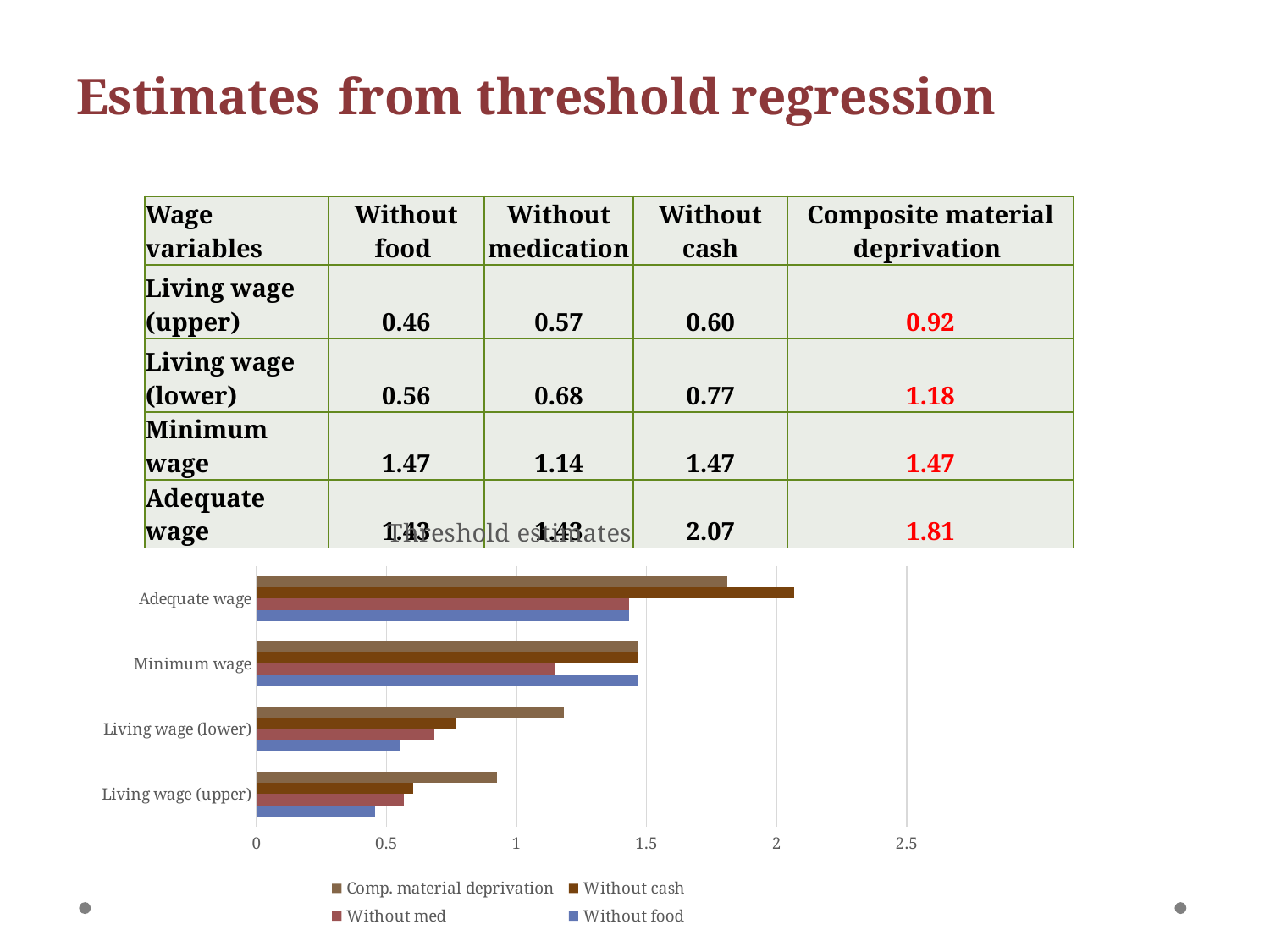
What is the Comp. material deprivation value for Living wage (upper)? 0.92 How many wage categories are plotted on the chart? 4 What is the difference between the Without cash value and the Without food value for Adequate wage? 0.63 What kind of chart is shown on the slide? bar chart How many series does the chart legend list? 4 Which wage category has the highest Comp. material deprivation value? Adequate wage Is the Without cash value for Adequate wage greater or less than 2? greater For Living wage (lower), which is larger: the Without cash value or the Without food value? Without cash Which series is shown in blue in the chart legend? Without food What is the Without cash value for Adequate wage? 2.07 What is the title of the chart? Threshold estimates Which wage category has the lowest Without food value? Living wage (upper)